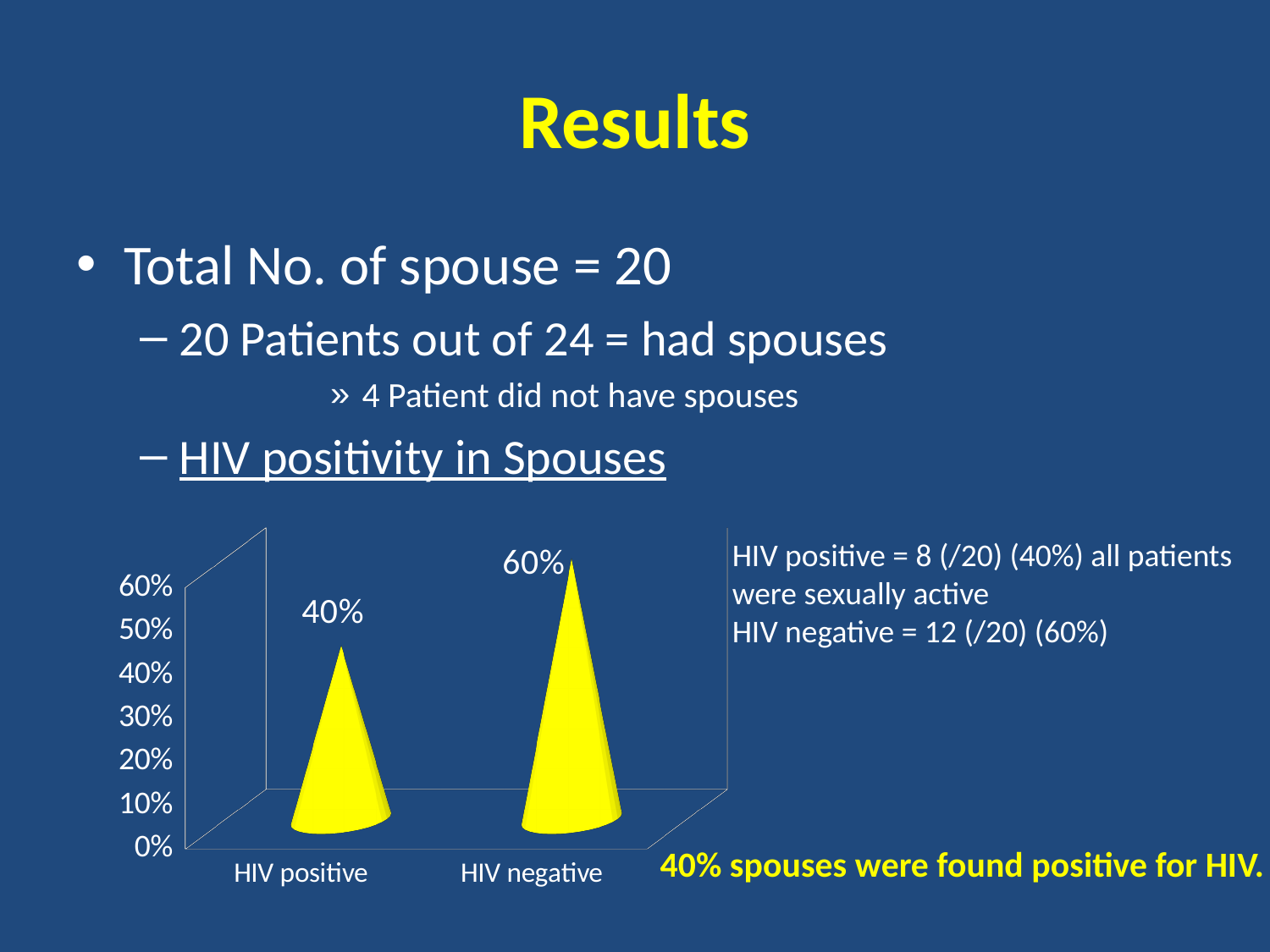
What kind of chart is shown on the slide? bar chart Which category has the lowest value in the chart? HIV positive What is the highest value shown on the chart's vertical axis? 60% What is the value for HIV negative in the chart? 60% What is the difference between the HIV negative and HIV positive values? 20% What is the value for HIV positive in the chart? 40% Which category has the highest value in the chart? HIV negative Which is larger, the value for HIV positive or HIV negative? HIV negative How many categories are shown in the chart? 2 What colour are the bars in the chart? yellow Is the value for HIV negative greater or less than 50%? greater Is the value for HIV positive greater or less than 50%? less